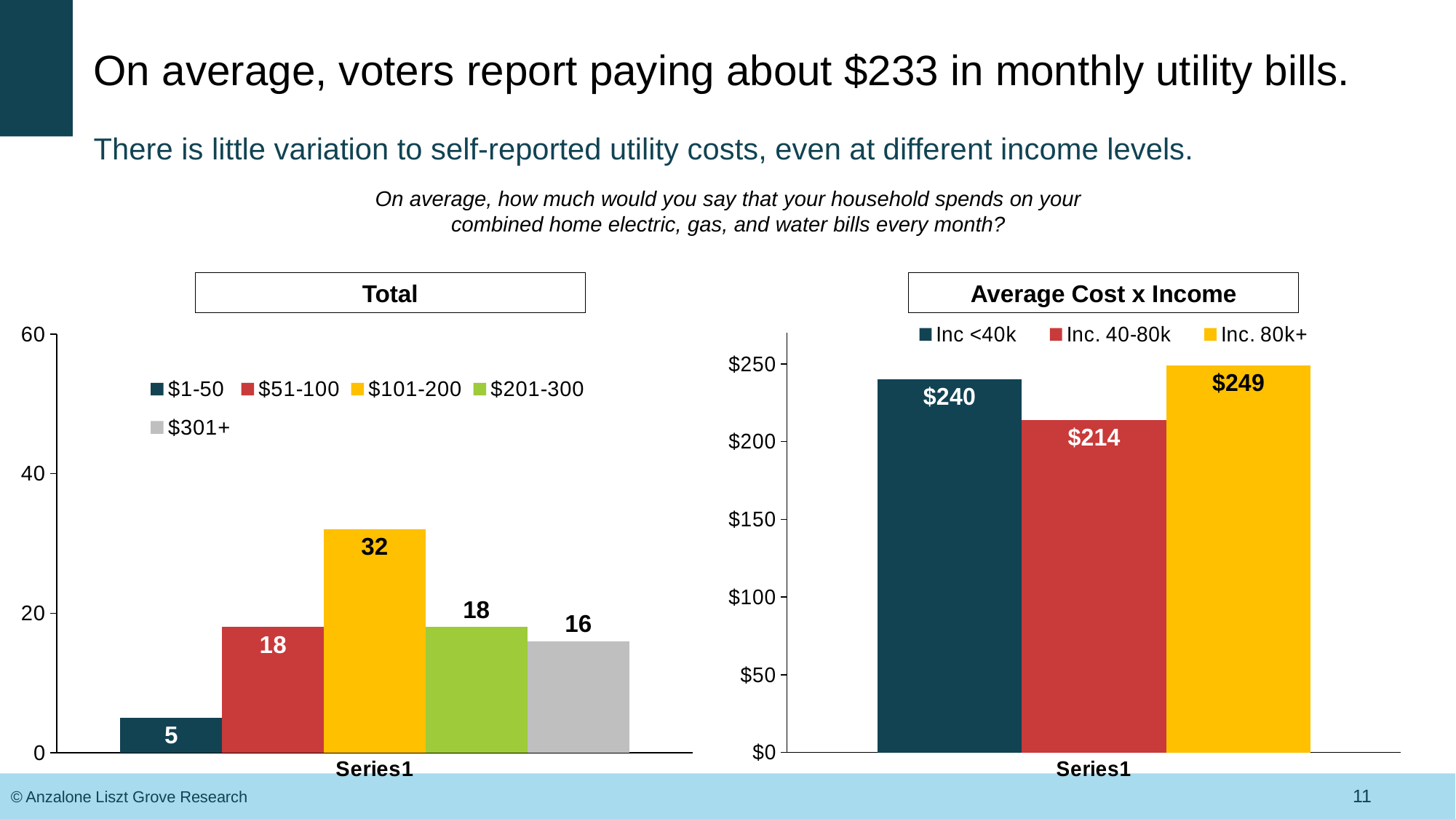
In the "Average Cost x Income" chart, what is the difference between the values for Inc. 80k+ and Inc <40k? $9 In the "Average Cost x Income" chart, which income group has the lowest average cost? Inc. 40-80k What kind of chart is the "Average Cost x Income" chart? Bar chart In the "Average Cost x Income" chart, what is the value for Inc. 80k+? $249 In the "Average Cost x Income" chart, which is larger, the value for Inc <40k or the value for Inc. 40-80k? Inc <40k In the "Total" chart, how many series does the legend list? 5 In the "Total" chart, what is the difference between the values for $101-200 and $301+? 16 In the "Total" chart, what is the value for $101-200? 32 In the "Total" chart, what is the value for $1-50? 5 In the "Total" chart, which category has the lowest value? $1-50 In the "Total" chart, which category has the highest value? $101-200 In the "Average Cost x Income" chart, what is the value for Inc. 40-80k? $214